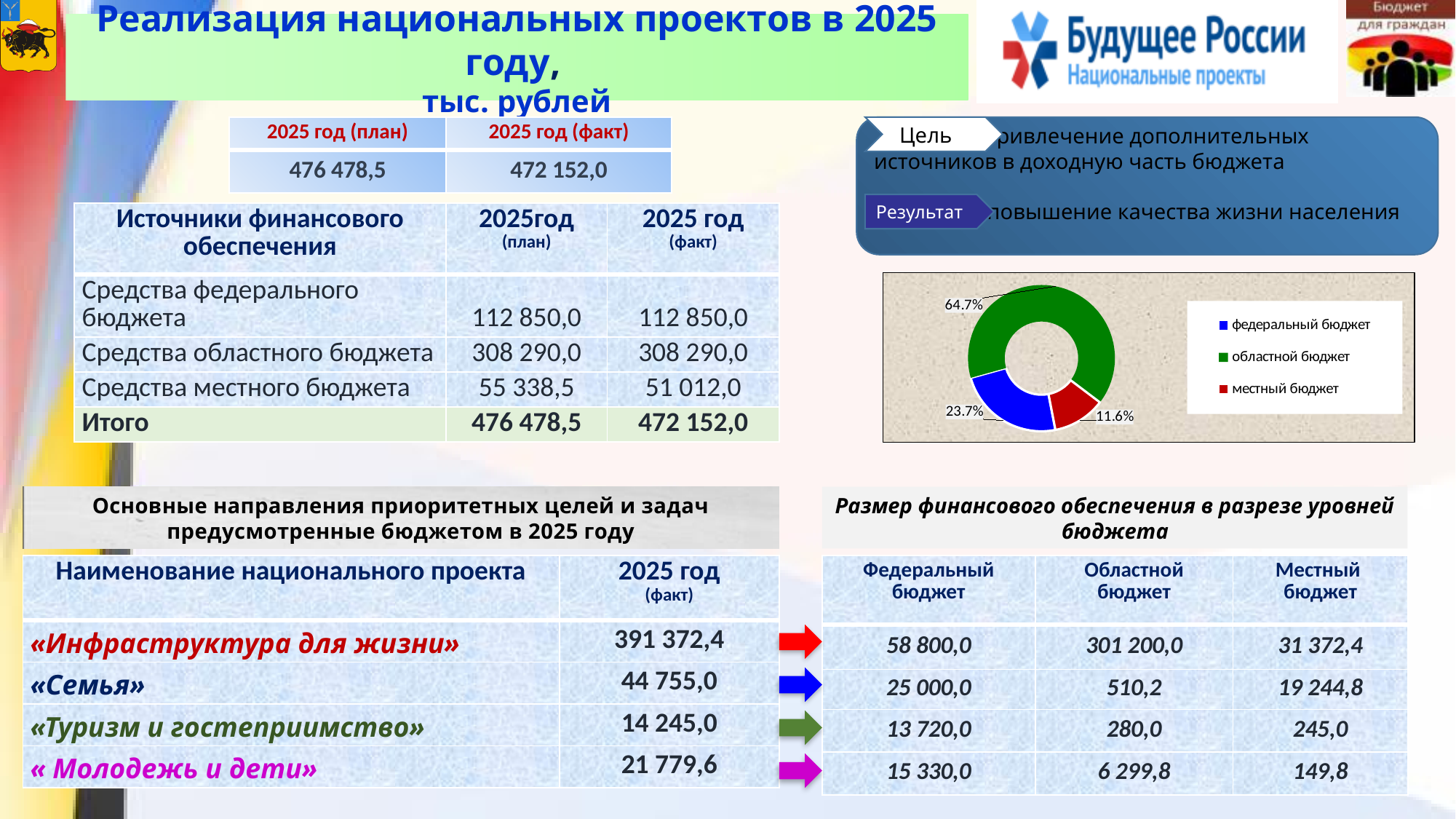
What share of the doughnut chart does федеральный бюджет have? 23.7% What share of the doughnut chart does местный бюджет have? 11.6% How many entries does the legend of the doughnut chart list? 3 What is the difference in percentage points between the областной бюджет slice and the федеральный бюджет slice? 41.0 What share of the doughnut chart does областной бюджет have? 64.7% How many slices does the doughnut chart have? 3 What colour is the местный бюджет slice in the doughnut chart? red Which is larger in the doughnut chart, федеральный бюджет or местный бюджет? федеральный бюджет What colour is the областной бюджет slice in the doughnut chart? green Which category has the largest slice in the doughnut chart? областной бюджет Which category has the smallest slice in the doughnut chart? местный бюджет What kind of chart is shown on the slide? doughnut chart